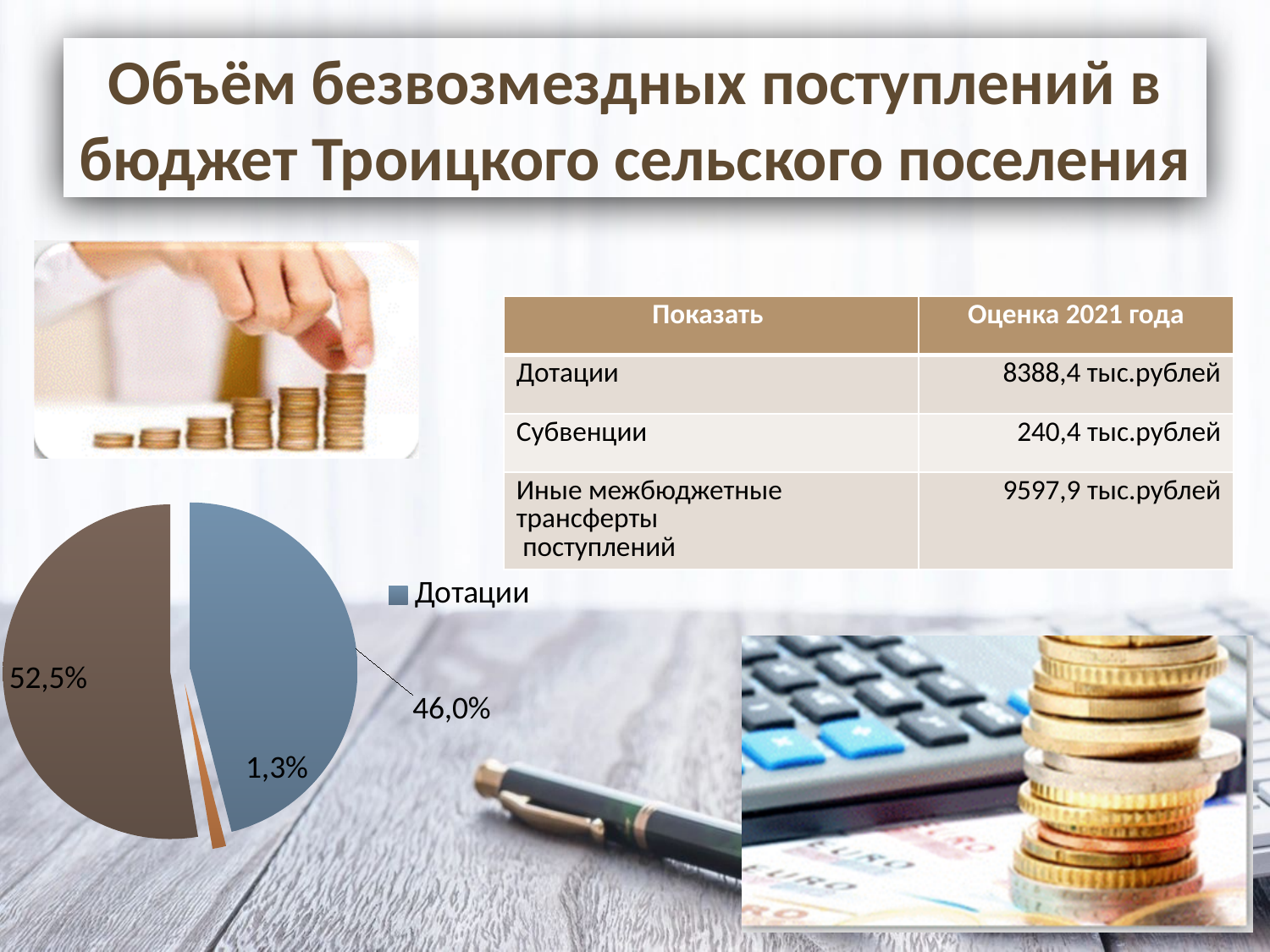
What colour is the Дотации slice in the pie chart? blue What kind of chart is shown on the slide? pie chart What share of the pie chart does Дотации represent? 46,0% What is the smallest percentage shown on the pie chart? 1,3% How many slices does the pie chart have? 3 Which entry is shown in the pie chart's legend? Дотации What is the difference between the largest slice (52,5%) and the Дотации slice (46,0%) in the pie chart? 6,5% What percentage label is shown on the orange slice of the pie chart? 1,3% Is the Дотации slice larger or smaller than the brown slice of the pie chart? smaller What is the largest percentage shown on the pie chart? 52,5%